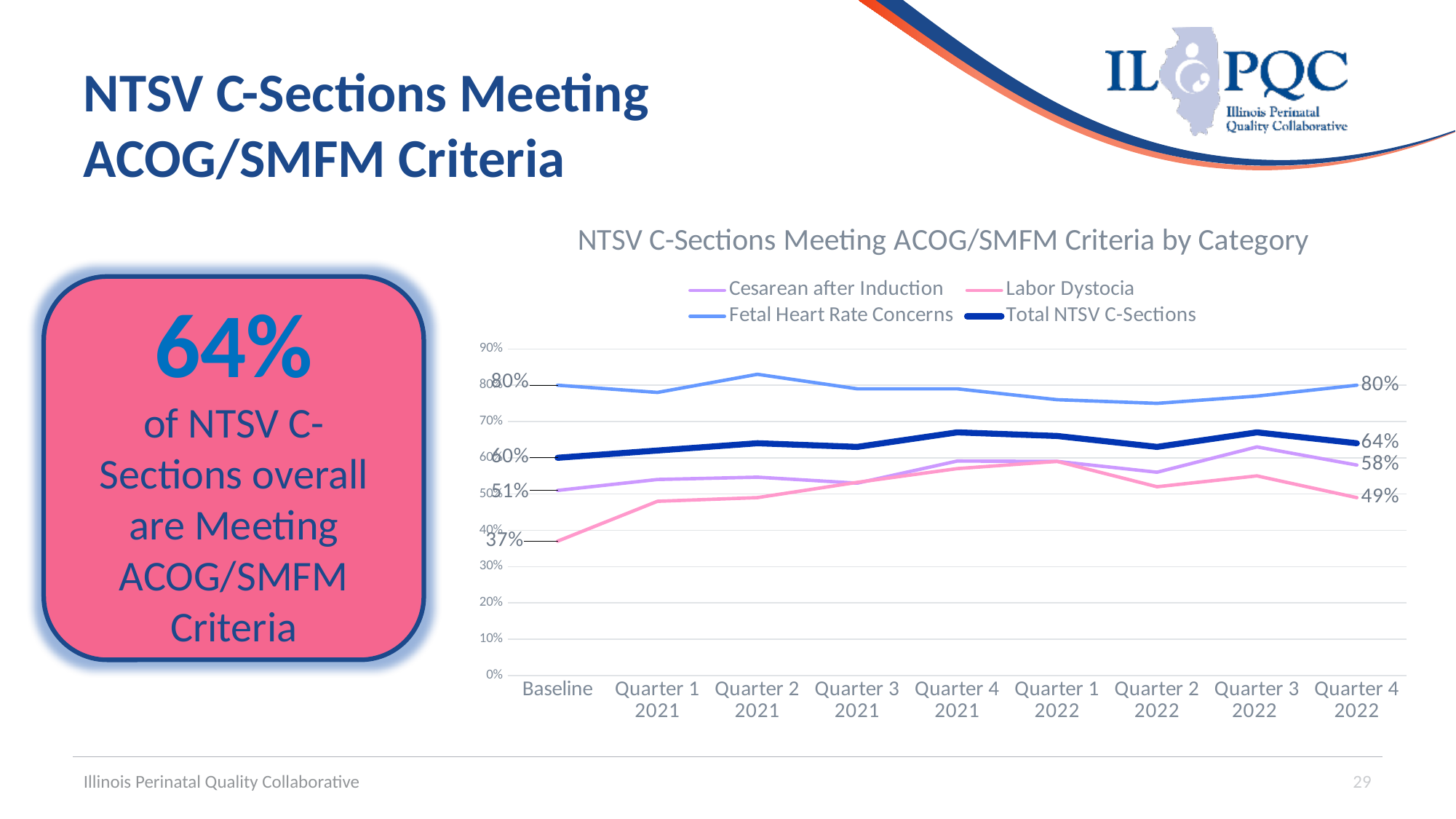
What is the value for Fetal Heart Rate Concerns at Baseline? 80% Which series has the highest value at Baseline? Fetal Heart Rate Concerns What is the value for Labor Dystocia at Baseline? 37% Is the value for Fetal Heart Rate Concerns at Quarter 2 2021 greater or less than 80%? greater By how many percentage points did Labor Dystocia change from Baseline to Quarter 4 2022? 12 percentage points How many series does the legend list? 4 How many time points are plotted along the x axis? 9 What is the difference between Total NTSV C-Sections at Quarter 4 2022 and at Baseline? 4 percentage points At Baseline, which is larger: Cesarean after Induction or Labor Dystocia? Cesarean after Induction What kind of chart is shown on the slide? Line chart What is the value for Total NTSV C-Sections at Quarter 4 2022? 64% What is the value for Cesarean after Induction at Quarter 4 2022? 58%